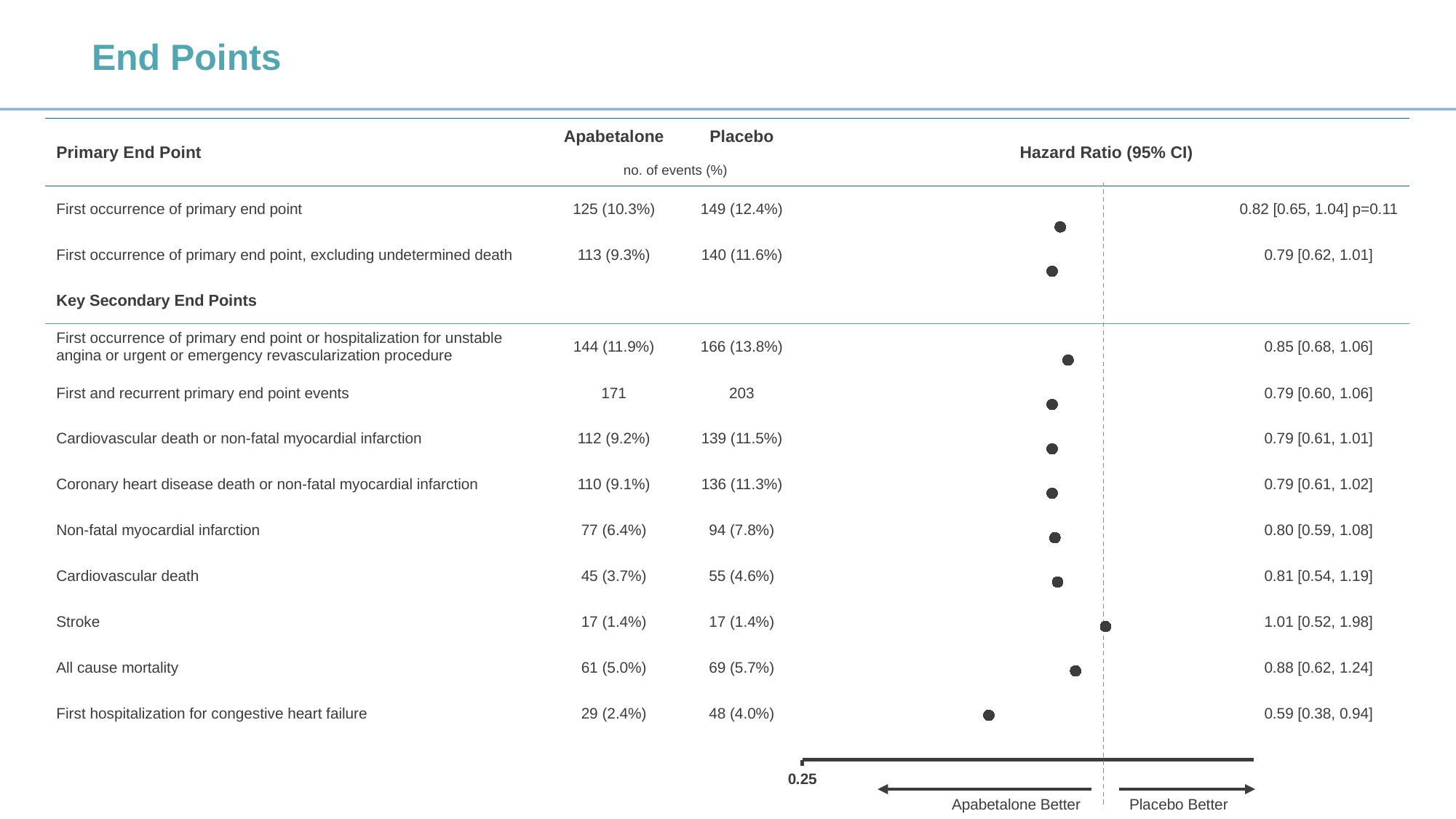
What is the hazard ratio for First hospitalization for congestive heart failure? 0.59 [0.38, 0.94] How many end points are plotted as points in the forest plot? 11 What is the difference between the hazard ratio for Stroke and the hazard ratio for First hospitalization for congestive heart failure? 0.42 What is the hazard ratio for All cause mortality? 0.88 [0.62, 1.24] Which has the larger hazard ratio, All cause mortality or Cardiovascular death? All cause mortality What is the hazard ratio for First occurrence of primary end point? 0.82 [0.65, 1.04] What is the hazard ratio for Stroke? 1.01 [0.52, 1.98] What does the label under the left-pointing arrow at the bottom of the plot say? Apabetalone Better What is the p-value shown for First occurrence of primary end point? p=0.11 What kind of chart is shown on the slide? Forest plot Which end point has the highest hazard ratio? Stroke Which end point has the lowest hazard ratio? First hospitalization for congestive heart failure